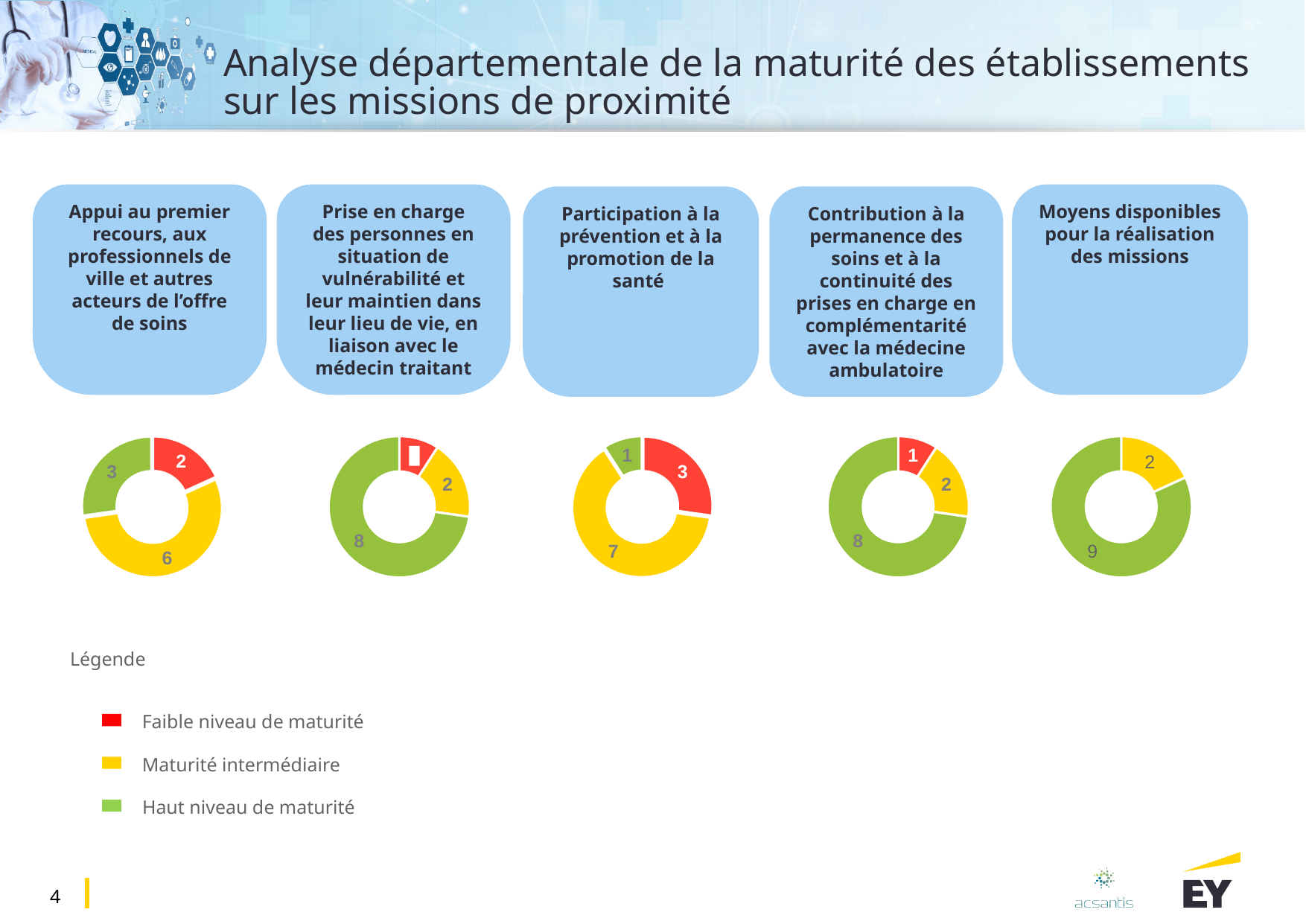
In the chart under "Participation à la prévention et à la promotion de la santé", which maturity level has the smallest slice? Haut niveau de maturité In the chart under "Appui au premier recours, aux professionnels de ville et autres acteurs de l'offre de soins", how many establishments have a "Maturité intermédiaire"? 6 In the chart under "Participation à la prévention et à la promotion de la santé", which maturity level has the largest slice? Maturité intermédiaire In the chart under "Prise en charge des personnes en situation de vulnérabilité et leur maintien dans leur lieu de vie, en liaison avec le médecin traitant", which is larger: the "Haut niveau de maturité" slice or the "Maturité intermédiaire" slice? Haut niveau de maturité What type of chart is used on this slide? Donut (pie) chart In the chart under "Participation à la prévention et à la promotion de la santé", what is the total of all slices? 11 In the chart under "Moyens disponibles pour la réalisation des missions", what is the difference between the "Haut niveau de maturité" value and the "Maturité intermédiaire" value? 7 In the chart under "Appui au premier recours, aux professionnels de ville et autres acteurs de l'offre de soins", how many establishments have a "Faible niveau de maturité"? 2 In the chart under "Moyens disponibles pour la réalisation des missions", how many slices does the donut have? 2 In the chart under "Contribution à la permanence des soins et à la continuité des prises en charge en complémentarité avec la médecine ambulatoire", what is the difference between the "Maturité intermédiaire" value and the "Faible niveau de maturité" value? 1 In the chart under "Contribution à la permanence des soins et à la continuité des prises en charge en complémentarité avec la médecine ambulatoire", what is the value for "Haut niveau de maturité"? 8 According to the legend, what does the red colour represent? Faible niveau de maturité